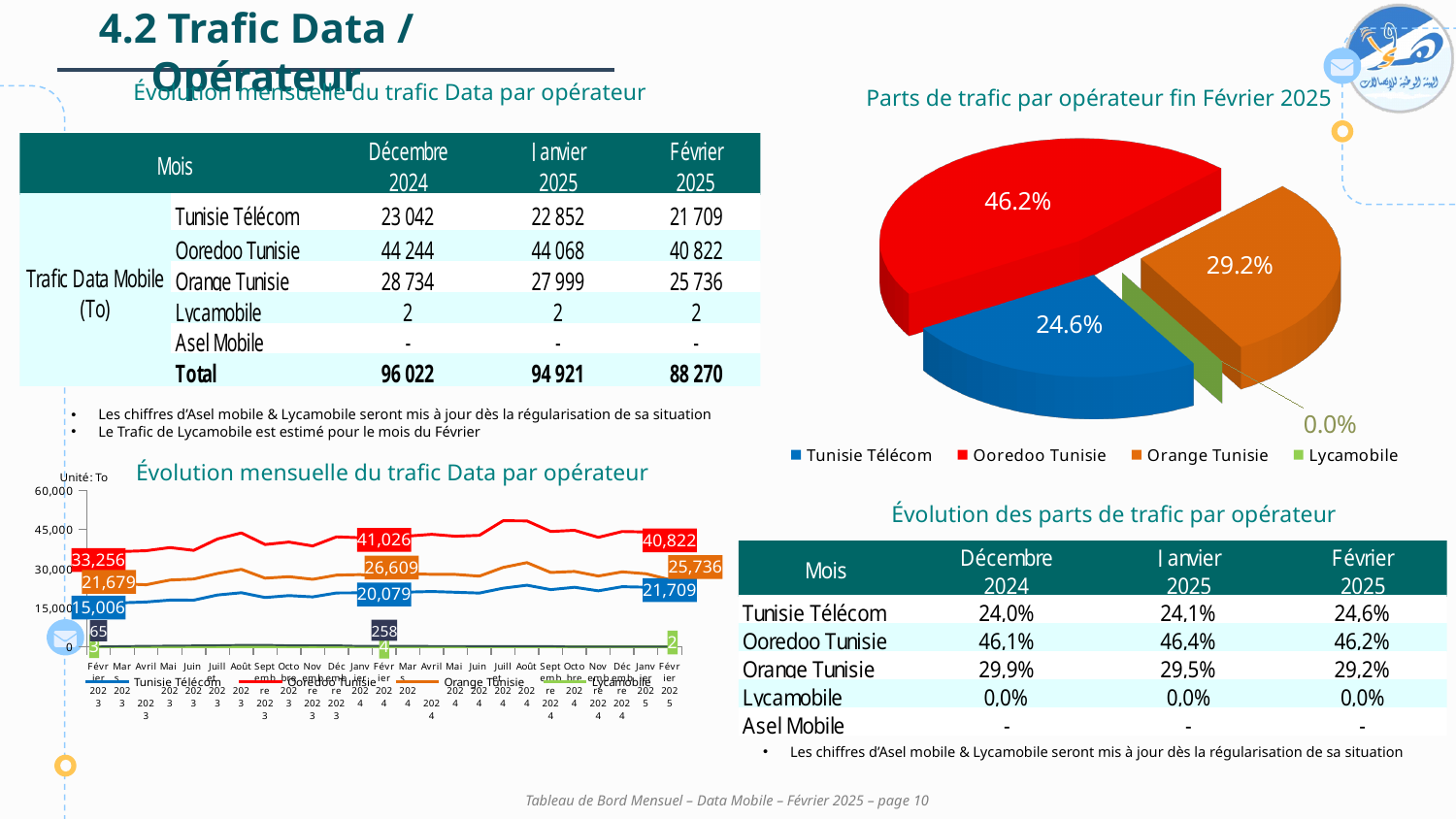
In the pie chart 'Parts de trafic par opérateur fin Février 2025', what is the difference between the shares of Ooredoo Tunisie and Tunisie Télécom? 21.6% In the line chart 'Évolution mensuelle du trafic Data par opérateur', which series has the highest values throughout the period? Ooredoo Tunisie In the pie chart 'Parts de trafic par opérateur fin Février 2025', what share does Ooredoo Tunisie hold? 46.2% In the line chart 'Évolution mensuelle du trafic Data par opérateur', what unit is indicated above the y axis? To In the line chart 'Évolution mensuelle du trafic Data par opérateur', is the value for Orange Tunisie at Févr 2025 greater or less than 30,000? less What kind of chart is 'Évolution mensuelle du trafic Data par opérateur' at the bottom left of the slide? Line chart In the line chart 'Évolution mensuelle du trafic Data par opérateur', what is the value labelled for Ooredoo Tunisie at Févr 2025? 40,822 In the pie chart 'Parts de trafic par opérateur fin Février 2025', which operator has the smallest share? Lycamobile In the pie chart 'Parts de trafic par opérateur fin Février 2025', how many operators does the legend list? 4 In the pie chart 'Parts de trafic par opérateur fin Février 2025', what share does Orange Tunisie hold? 29.2% In the line chart 'Évolution mensuelle du trafic Data par opérateur', what is the value labelled for Tunisie Télécom at the first point (Févr 2023)? 15,006 In the pie chart 'Parts de trafic par opérateur fin Février 2025', which operator has the largest share? Ooredoo Tunisie